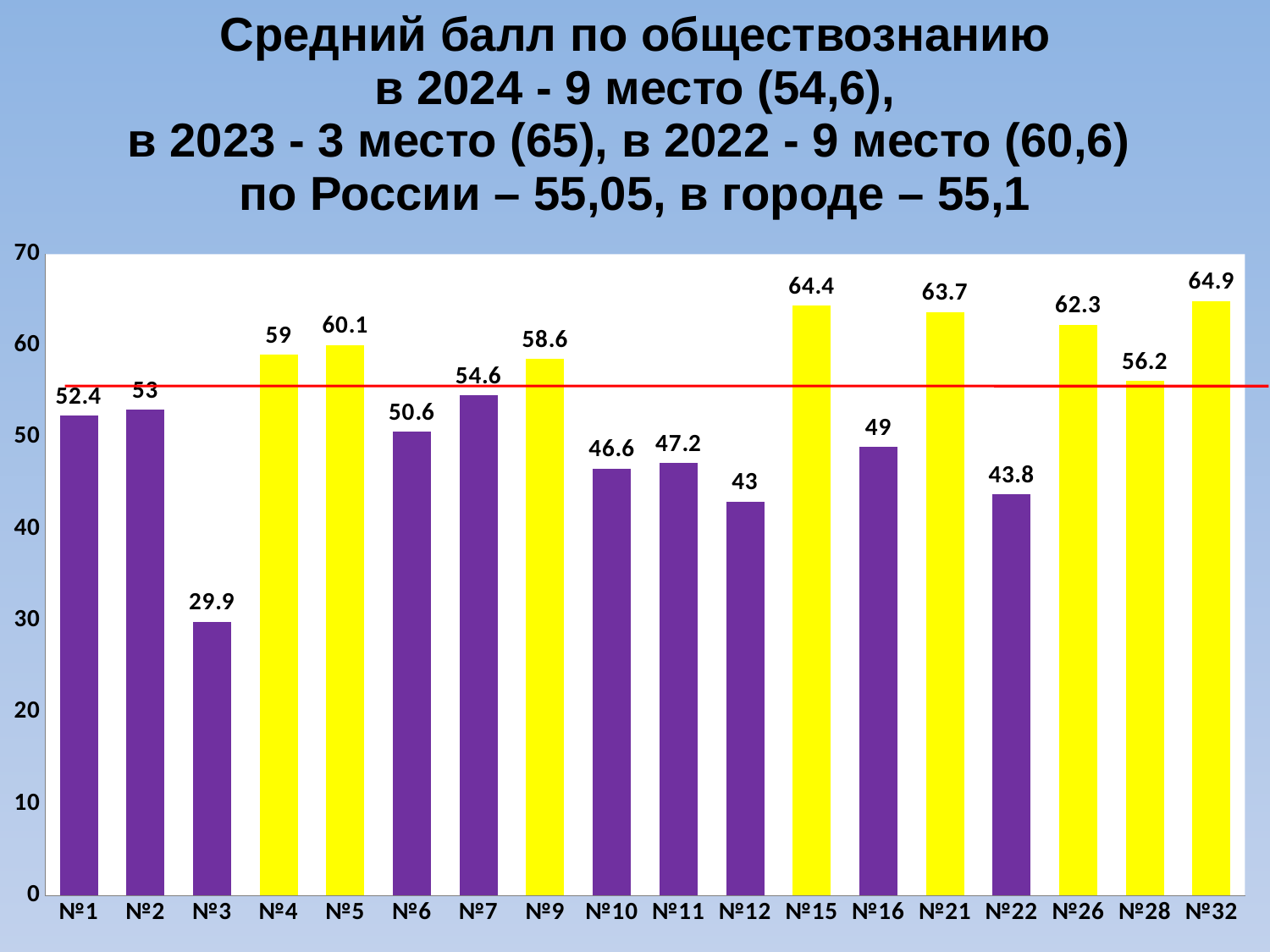
Which is larger, the value for №6 or the value for №7? №7 What is the value for №3? 29.9 What is the difference between the values for №32 and №3? 35 Is the value for №10 greater or less than 50? less How many categories are shown on the x axis? 18 Which category has the highest value? №32 What kind of chart is shown on the slide? bar chart What is the value for №28? 56.2 Which category has the lowest value? №3 How many bars are coloured yellow? 8 What is the value for №15? 64.4 What is the difference between the values for №5 and №4? 1.1